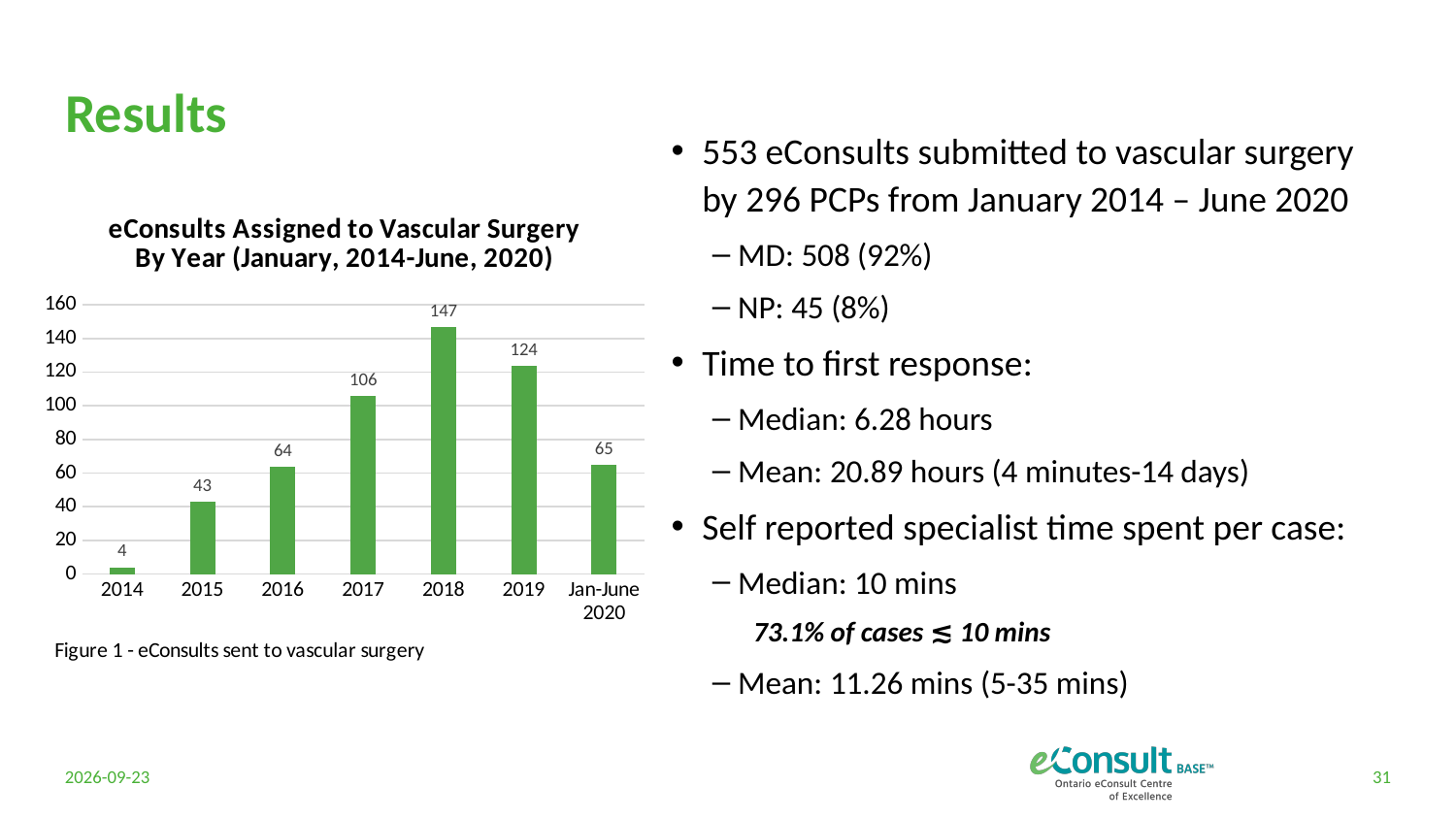
What is the difference between the values for 2017 and 2016? 42 Which is larger, the value for 2016 or the value for Jan-June 2020? Jan-June 2020 What kind of chart is shown? bar chart What is the difference between the values for 2018 and 2019? 23 What is the value for 2015? 43 Is the value for 2019 greater or less than 100? greater How many categories are shown on the x axis? 7 Which year has the lowest number of eConsults? 2014 Which year has the highest number of eConsults? 2018 What is the value for Jan-June 2020? 65 What is the title of the chart? eConsults Assigned to Vascular Surgery By Year (January, 2014-June, 2020) What is the value for 2018? 147